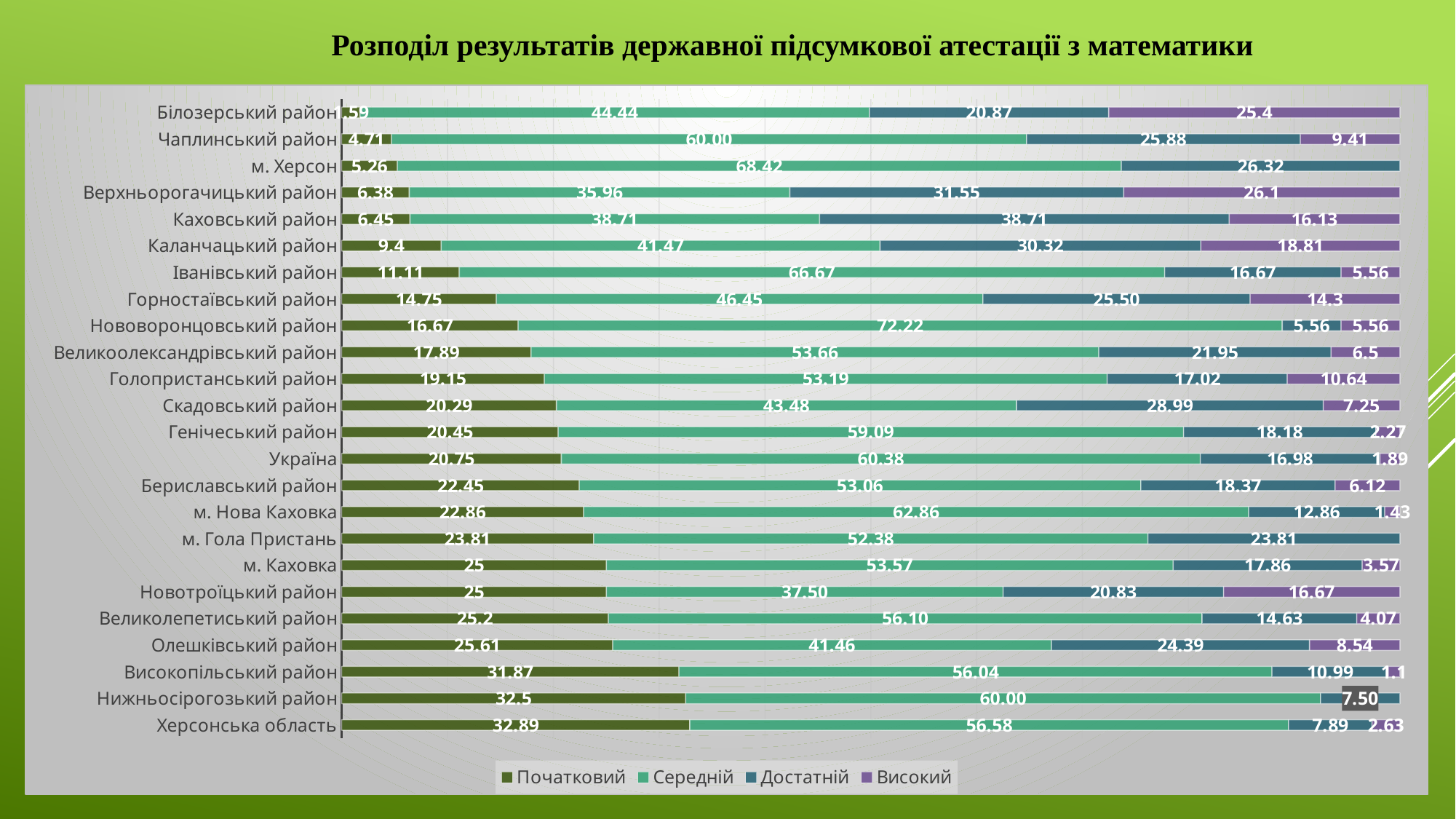
How many series does the legend list? 4 Which has the larger Середній value, м. Херсон or Іванівський район? м. Херсон What is the Високий value for Білозерський район? 25.4 What is the total of the stacked bar for Україна? 100.00 Which category has the highest Початковий value? Херсонська область How many categories are shown on the chart? 24 Which category has the highest Середній value? Нововоронцовський район What is the Початковий value for Херсонська область? 32.89 What is the difference between the Початковий values for Херсонська область and Україна? 12.14 What is the Середній value for Нововоронцовський район? 72.22 What is the Достатній value for Каховський район? 38.71 What kind of chart is shown on the slide? Stacked bar chart